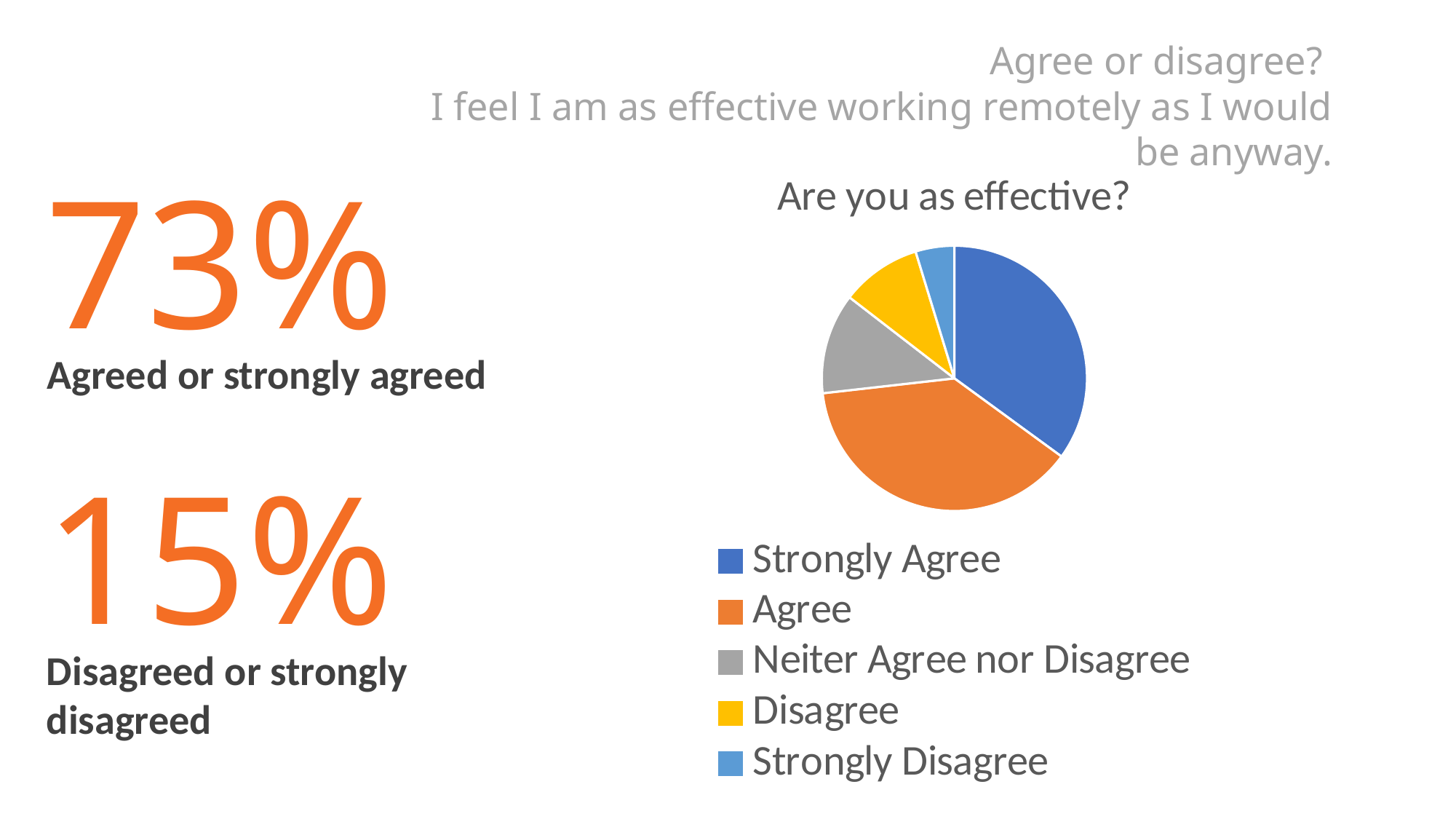
What colour is the Agree slice in the pie chart? orange Which slice is larger, Agree or Strongly Agree? Agree What kind of chart is shown on the slide? pie chart Which slice is larger, Agree or Disagree? Agree How many categories does the pie chart's legend list? 5 Which slice is larger, Disagree or Strongly Disagree? Disagree Which category has the smallest slice of the pie chart? Strongly Disagree How many slices does the pie chart have? 5 What is the title of the pie chart? Are you as effective? Which category has the largest slice of the pie chart? Agree